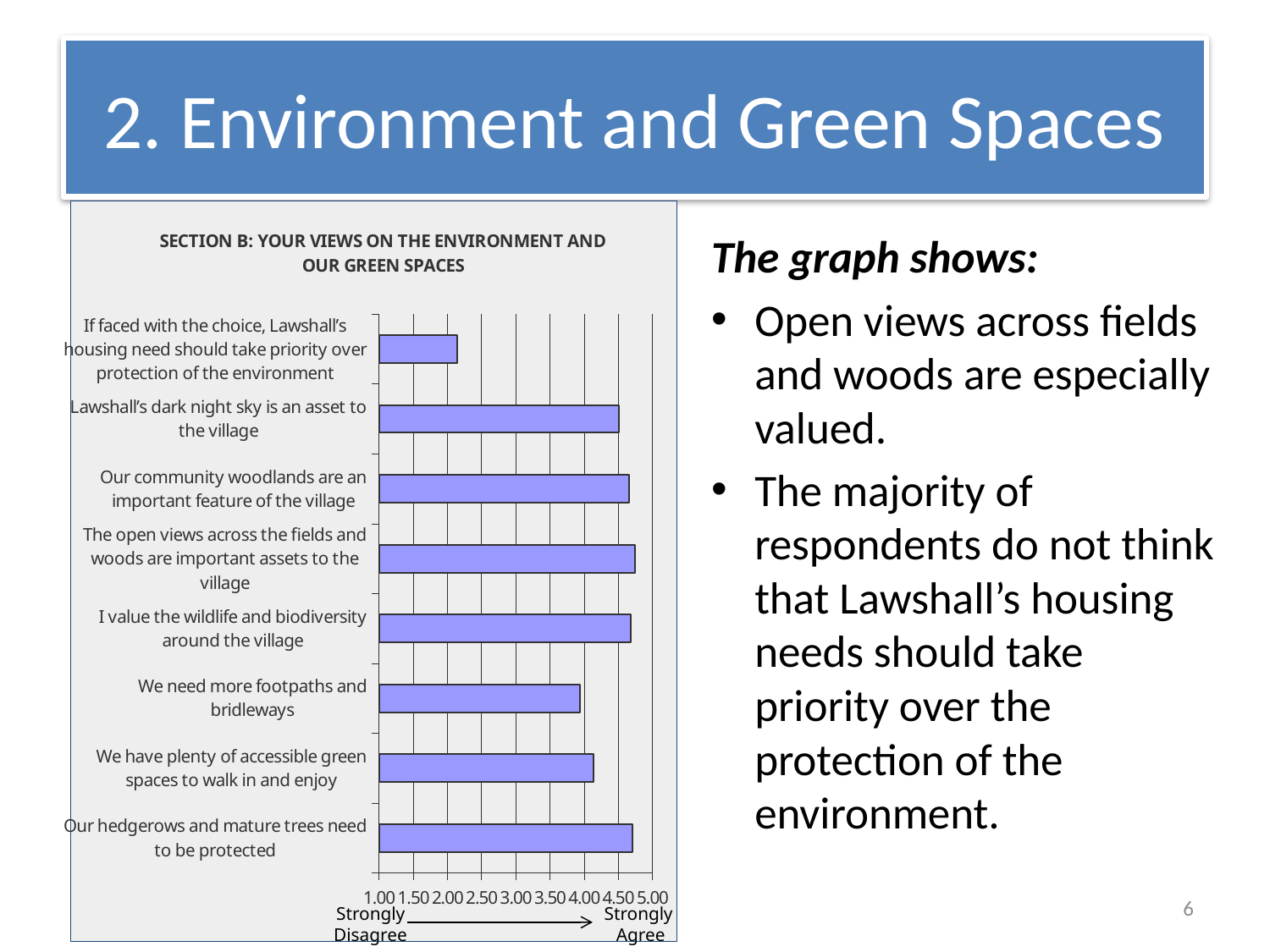
Which statement has the lowest average score in the chart? If faced with the choice, Lawshall's housing need should take priority over protection of the environment Is the value for "Our hedgerows and mature trees need to be protected" greater or less than 4.50? greater Which has the larger value: "We have plenty of accessible green spaces to walk in and enjoy" or "If faced with the choice, Lawshall's housing need should take priority over protection of the environment"? We have plenty of accessible green spaces to walk in and enjoy Which has the larger value: "Lawshall's dark night sky is an asset to the village" or "We need more footpaths and bridleways"? Lawshall's dark night sky is an asset to the village Is the value for "The open views across the fields and woods are important assets to the village" greater or less than 4.50? greater What is the title of the chart? SECTION B: YOUR VIEWS ON THE ENVIRONMENT AND OUR GREEN SPACES Is the value for "We need more footpaths and bridleways" greater or less than 3.50? greater What do the two ends of the horizontal axis represent, according to the labels below it? Strongly Disagree to Strongly Agree What kind of chart is shown on the slide? bar chart How many statements (categories) are plotted in the chart? 8